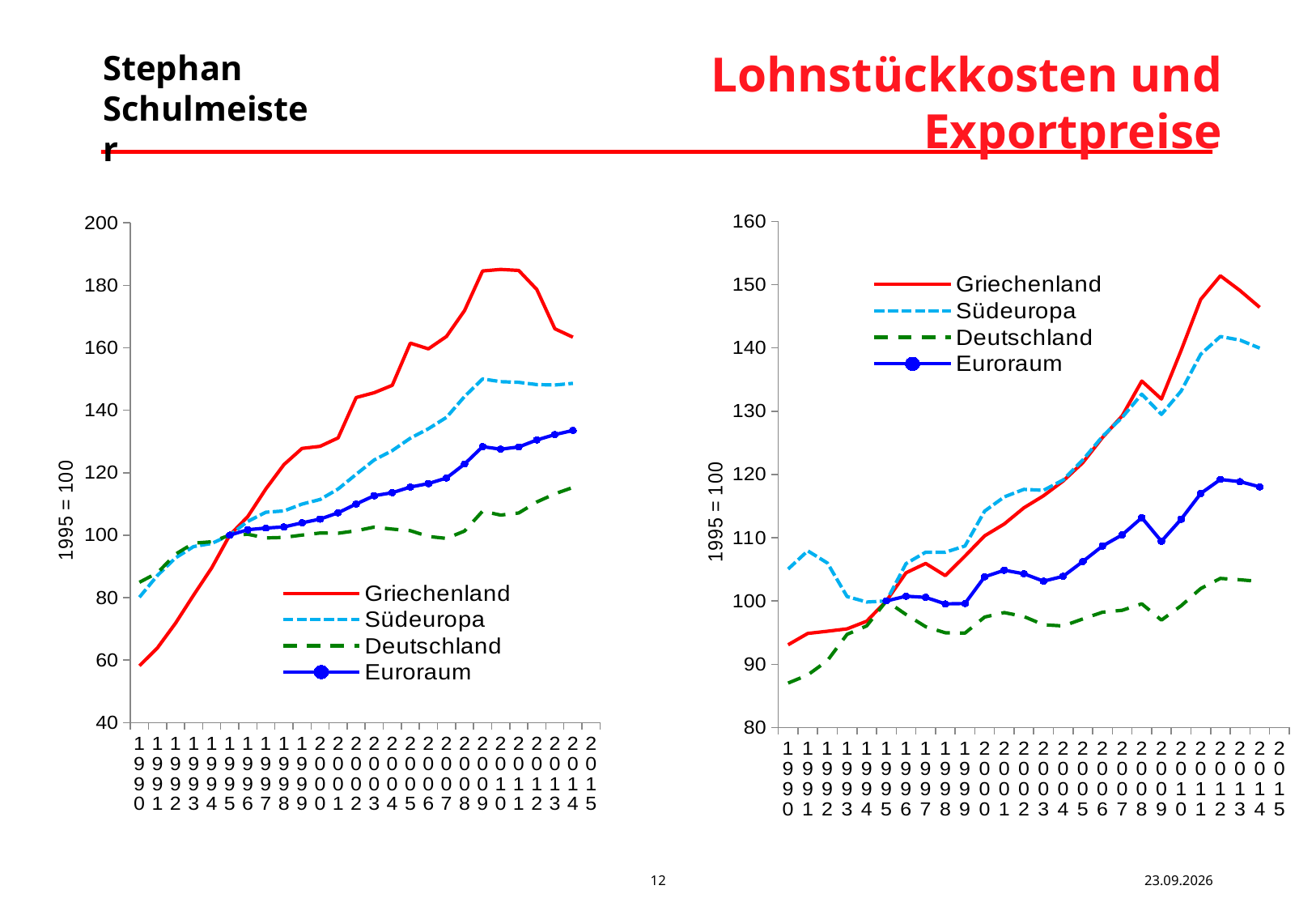
How many years are plotted along the x axis of the right chart? 26 In the right chart, is the value for Deutschland in 1990 greater or less than 90? less How many series does the legend of the left chart list? 4 In the left chart, is the value for Griechenland in 1990 greater or less than 80? less In the right chart, is the value for Griechenland in 2012 greater or less than 140? greater In the left chart, do the values for Euroraum rise or fall from 1990 to 2015? rise What is the y-axis label of the right chart? 1995 = 100 What kind of chart is the left chart on the slide? line chart